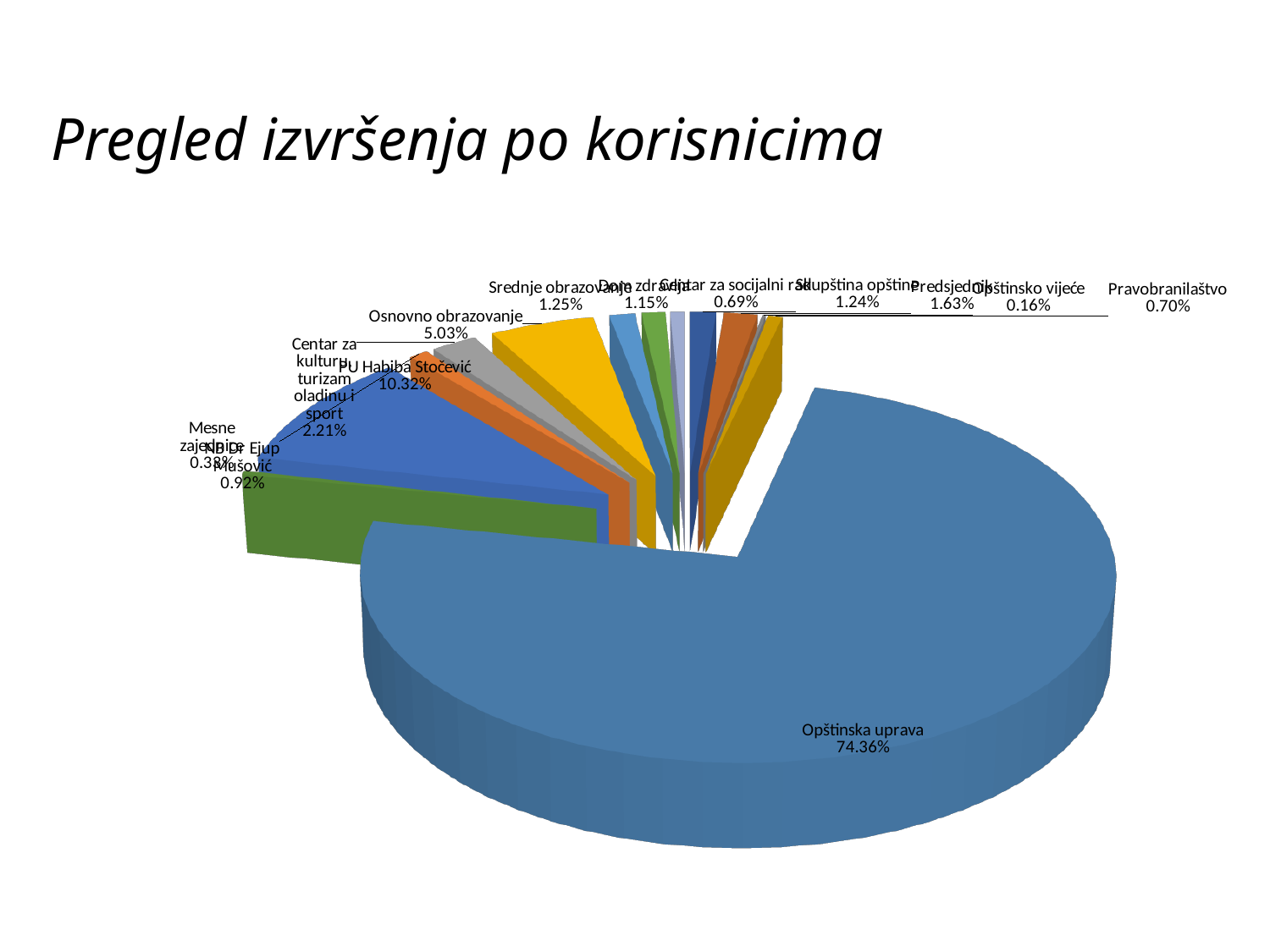
What is the difference in percentage points between Opštinska uprava and PU Habiba Stočević? 64.04 What share of the pie does Osnovno obrazovanje have? 5.03% What kind of chart is shown on the slide? pie chart What is the title of the slide? Pregled izvršenja po korisnicima Which is larger, the share for Osnovno obrazovanje or the share for Srednje obrazovanje? Osnovno obrazovanje Which category has the smallest slice of the pie? Opštinsko vijeće What share of the pie does PU Habiba Stočević have? 10.32% What share of the pie does Centar za kulturu, turizam, omladinu i sport have? 2.21% Which category has the largest slice of the pie? Opštinska uprava What share of the pie does Opštinska uprava have? 74.36% What share of the pie does Pravobranilaštvo have? 0.70% What share of the pie does Predsjednik have? 1.63%